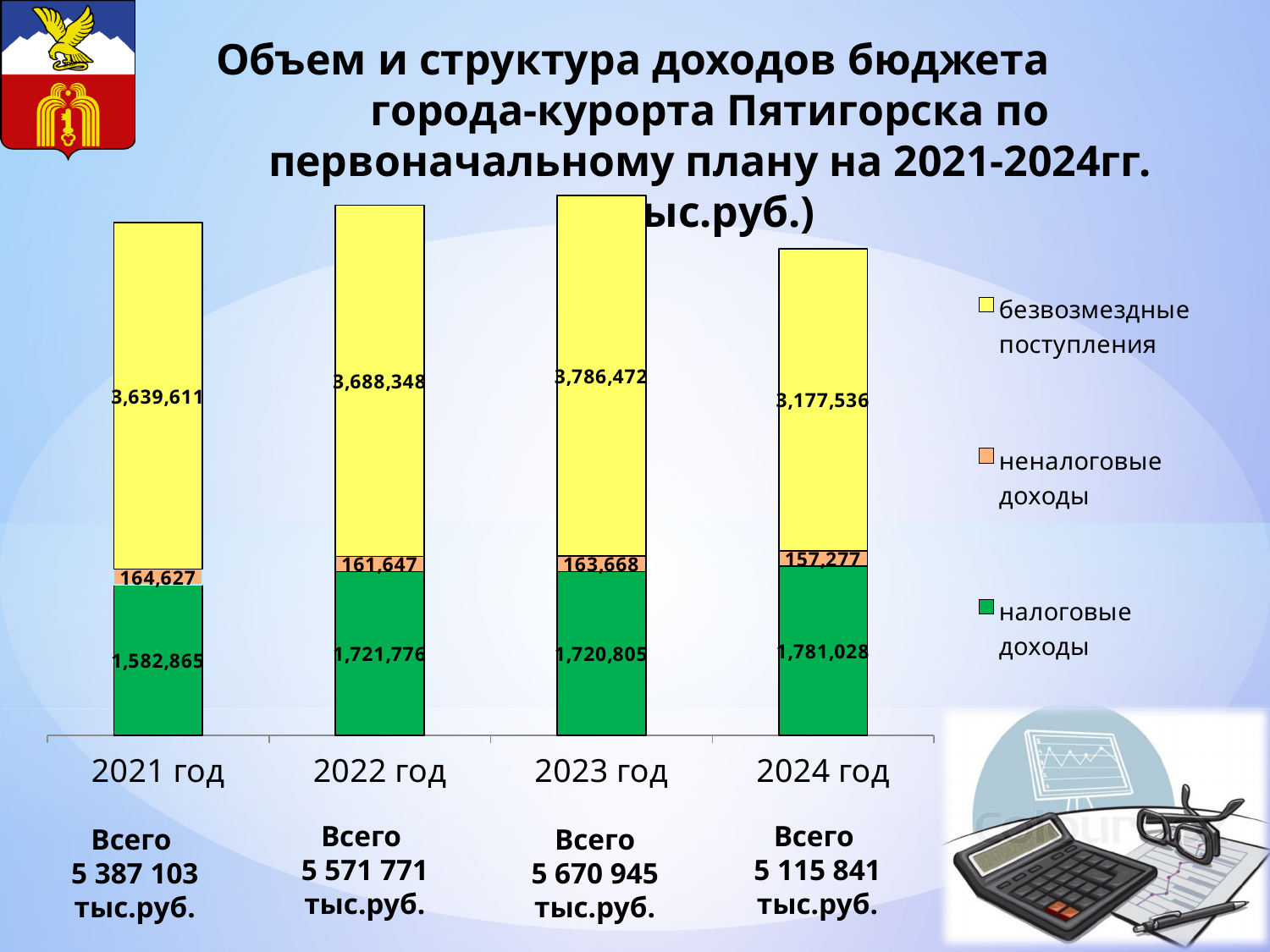
Which year has larger безвозмездные поступления, 2022 год or 2024 год? 2022 год In which year are неналоговые доходы the lowest? 2024 год In which year are безвозмездные поступления the highest? 2023 год What kind of chart is shown on the slide? Stacked bar chart What is the value of безвозмездные поступления for 2023 год? 3,786,472 How many years are shown on the x axis? 4 What is the value of налоговые доходы for 2021 год? 1,582,865 How many series does the legend list? 3 What is the total (Всего) for 2023 год? 5 670 945 тыс.руб. Which series is shown in yellow? безвозмездные поступления By how much do налоговые доходы in 2024 год exceed those in 2021 год? 198,163 What is the value of неналоговые доходы for 2024 год? 157,277